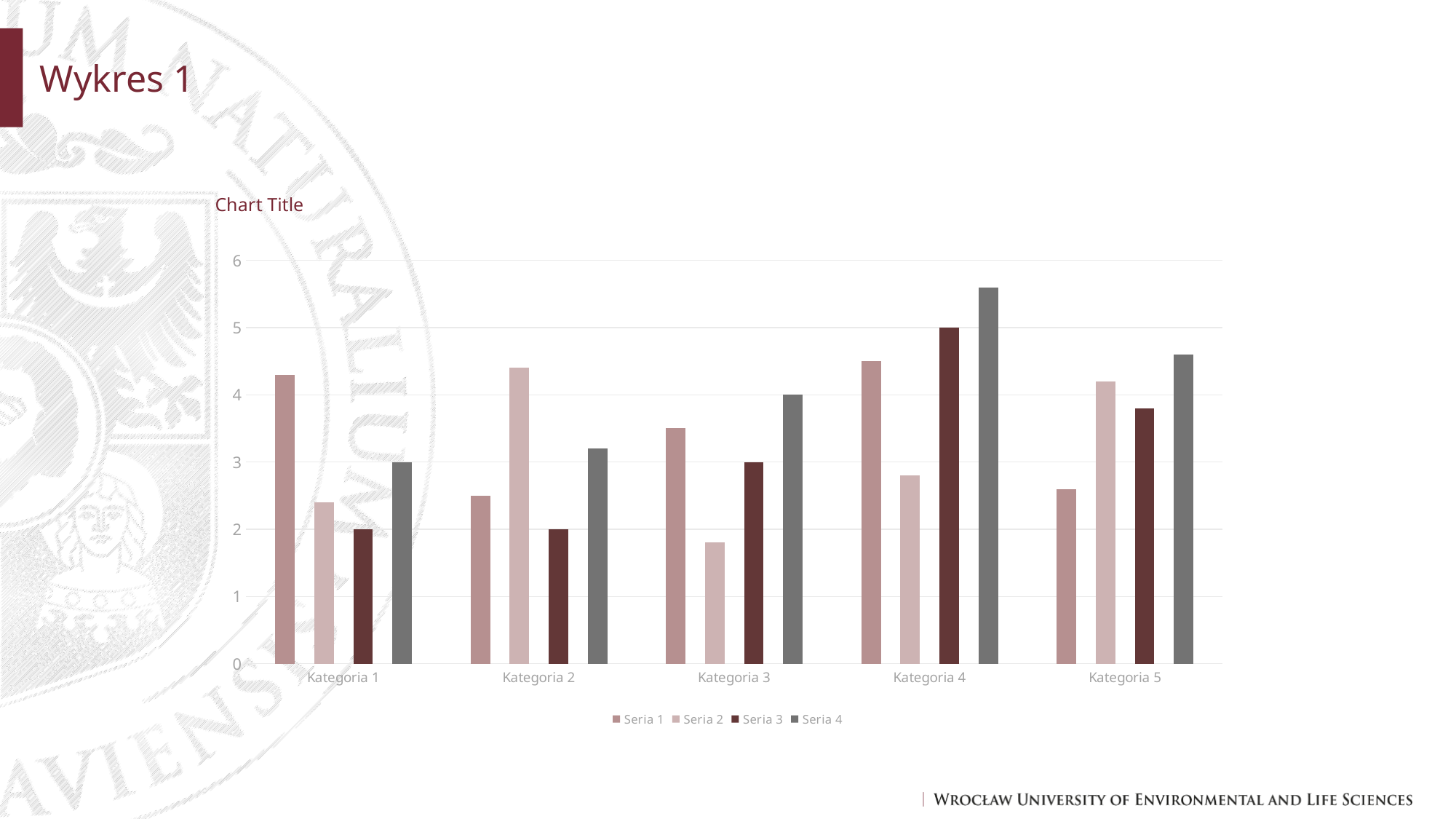
What is the title shown above the chart? Chart Title Is the value of Seria 4 for Kategoria 4 greater or less than 5? greater How many categories are shown on the x axis of the chart? 5 For Kategoria 2, which is larger: Seria 1 or Seria 2? Seria 2 What is the value of Seria 4 for Kategoria 3? 4 What kind of chart is shown on the slide? bar chart What is the value of Seria 3 for Kategoria 4? 5 Which category has the highest value for Seria 4? Kategoria 4 How many series does the chart's legend list? 4 What is the value of Seria 4 for Kategoria 1? 3 Which category has the lowest value for Seria 2? Kategoria 3 What is the value of Seria 3 for Kategoria 1? 2